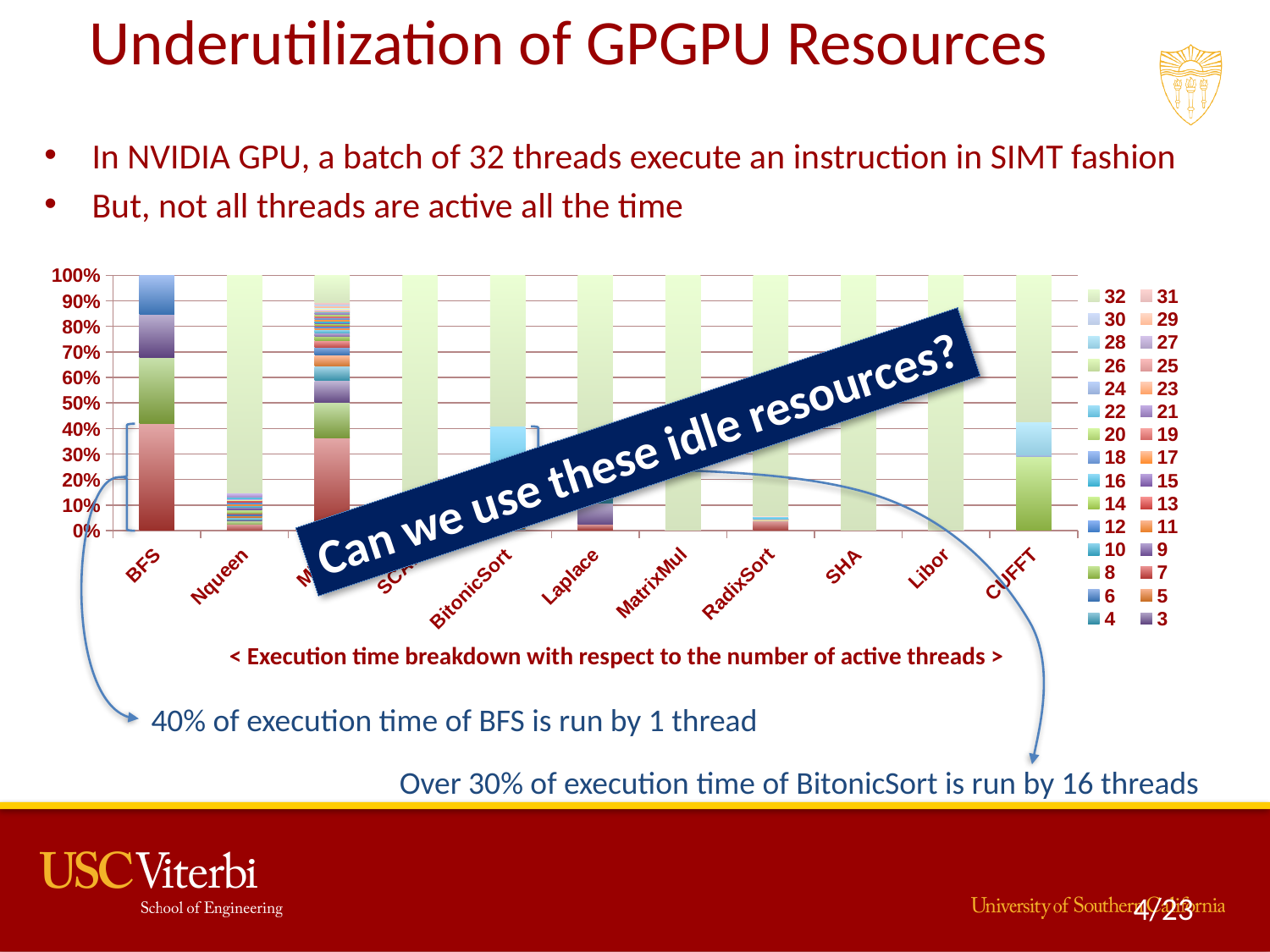
How many bars (benchmarks) are plotted in the chart? 11 Is the top (32-thread) segment of the CUFFT bar greater or less than 50%? greater Is the top (32-thread) segment of the Nqueen bar greater or less than 70%? greater What is the smallest series number listed in the legend? 3 What kind of chart is shown on the slide? stacked bar chart Which bar has the larger 32-thread (top green) share, BFS or SHA? SHA Is the bottom (red) segment of the BFS bar greater or less than 30%? greater What is the largest series number listed in the legend? 32 Which bar has the larger 32-thread (top green) share, CUFFT or Libor? Libor What caption is printed below the chart? < Execution time breakdown with respect to the number of active threads > What is the highest value shown on the chart's y axis? 100% How many series does the chart legend list? 30